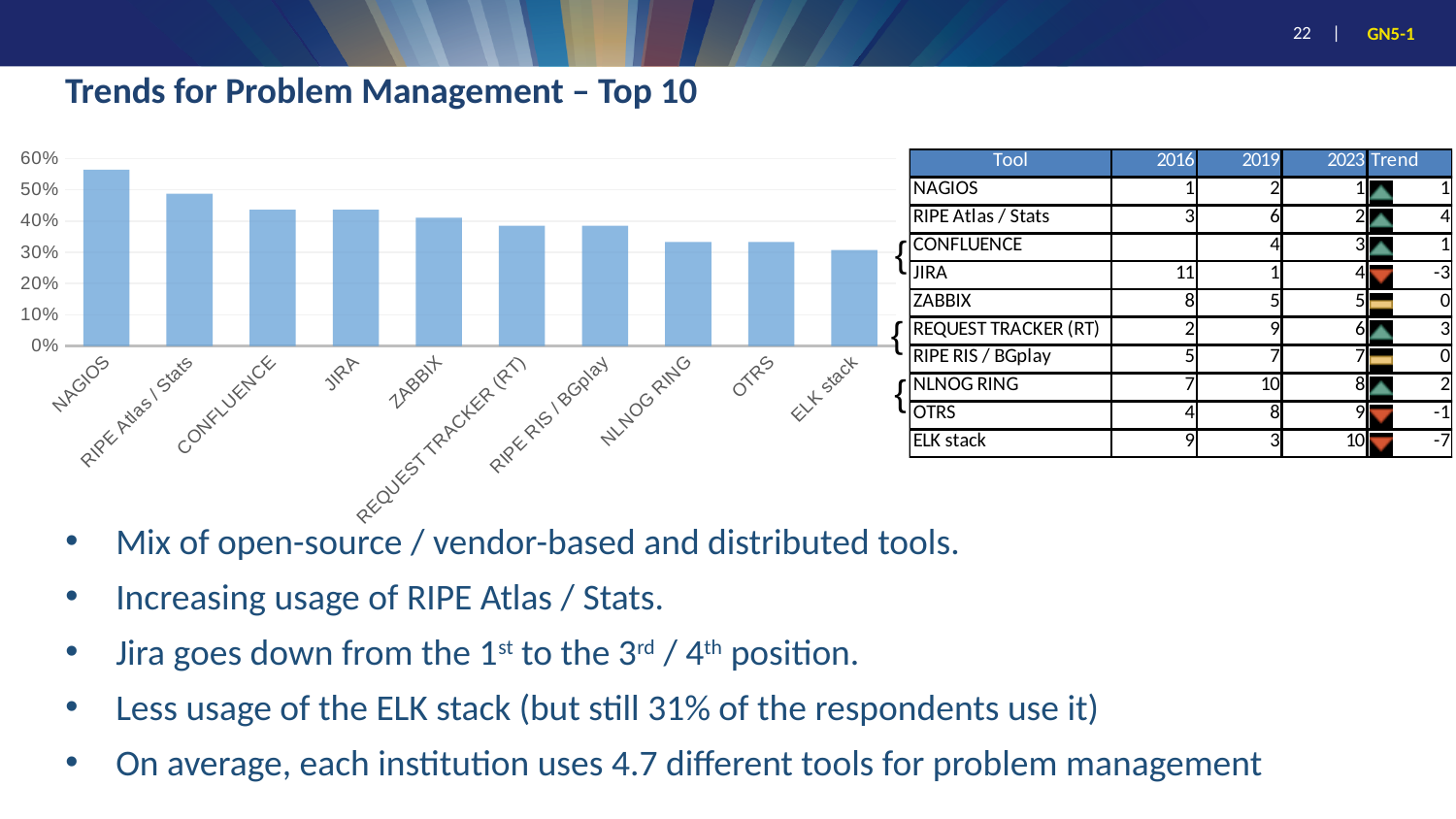
What kind of chart is shown on the slide? bar chart Which tool has the lowest bar in the chart? ELK stack Is the value for NAGIOS greater or less than 50%? greater Is the value for RIPE Atlas / Stats greater or less than 50%? less Do the bar values rise or fall from left to right across the chart? fall How many tools are shown as bars in the chart? 10 Is the value for NLNOG RING greater or less than 40%? less Which tool has the highest bar in the chart? NAGIOS What is the title of the slide containing the chart? Trends for Problem Management – Top 10 Which has a larger value, NAGIOS or ZABBIX? NAGIOS